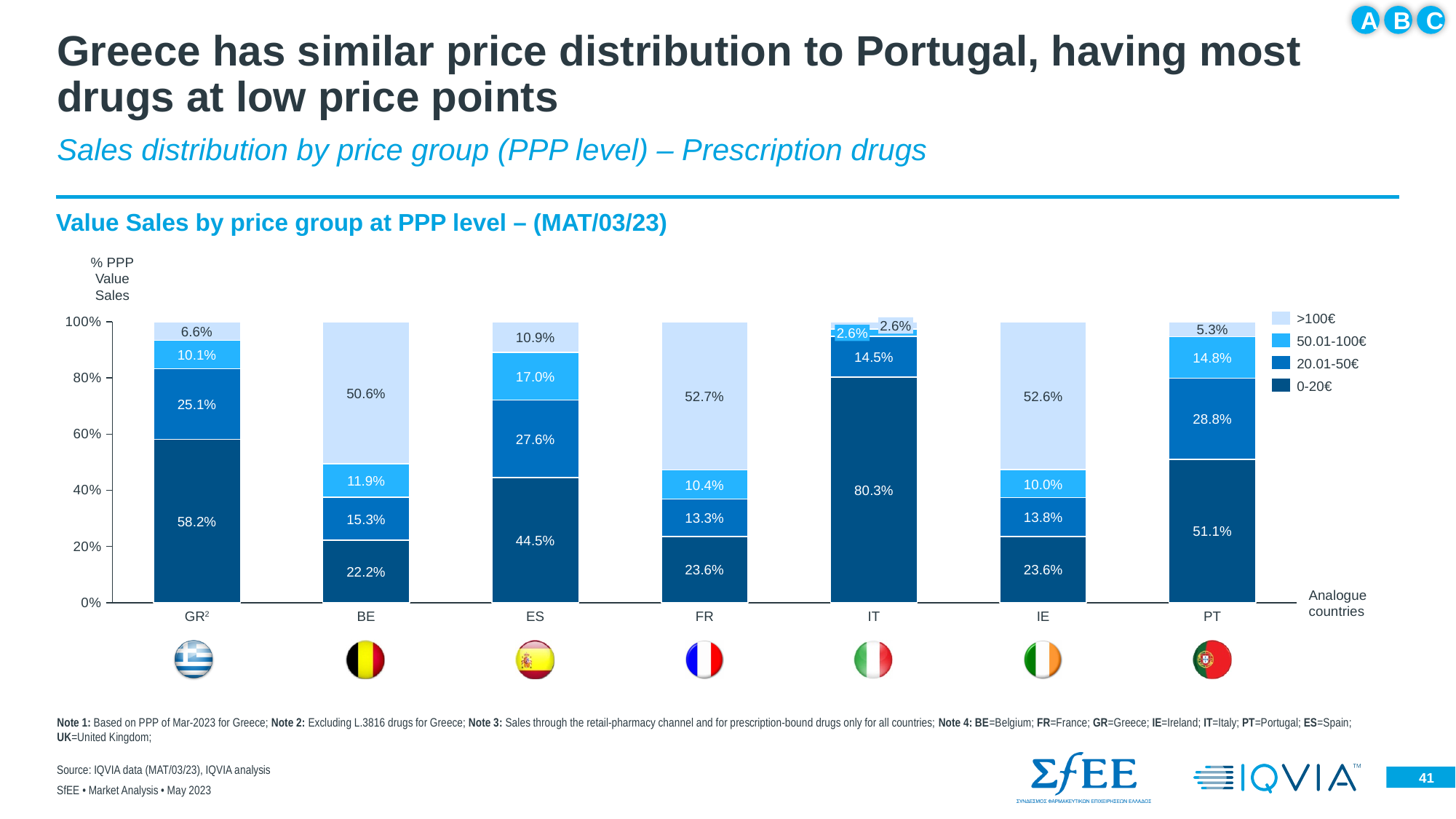
Which country has the lowest share in the 0-20€ price group? BE What type of chart is used on this slide? Stacked bar chart What is the 20.01-50€ share for Belgium (BE)? 15.3% Which country has the highest share in the 0-20€ price group? IT Which country has the lowest share in the >100€ price group? IT What is the difference in percentage points between the 0-20€ share of GR and that of PT? 7.1 How many countries are shown on the x axis? 7 What share of value sales in Greece (GR) falls in the 0-20€ price group? 58.2% What is the >100€ share for France (FR)? 52.7% How many price groups does the legend list? 4 What is the 50.01-100€ share for Portugal (PT)? 14.8% Which has a larger 0-20€ share, Spain (ES) or Portugal (PT)? PT